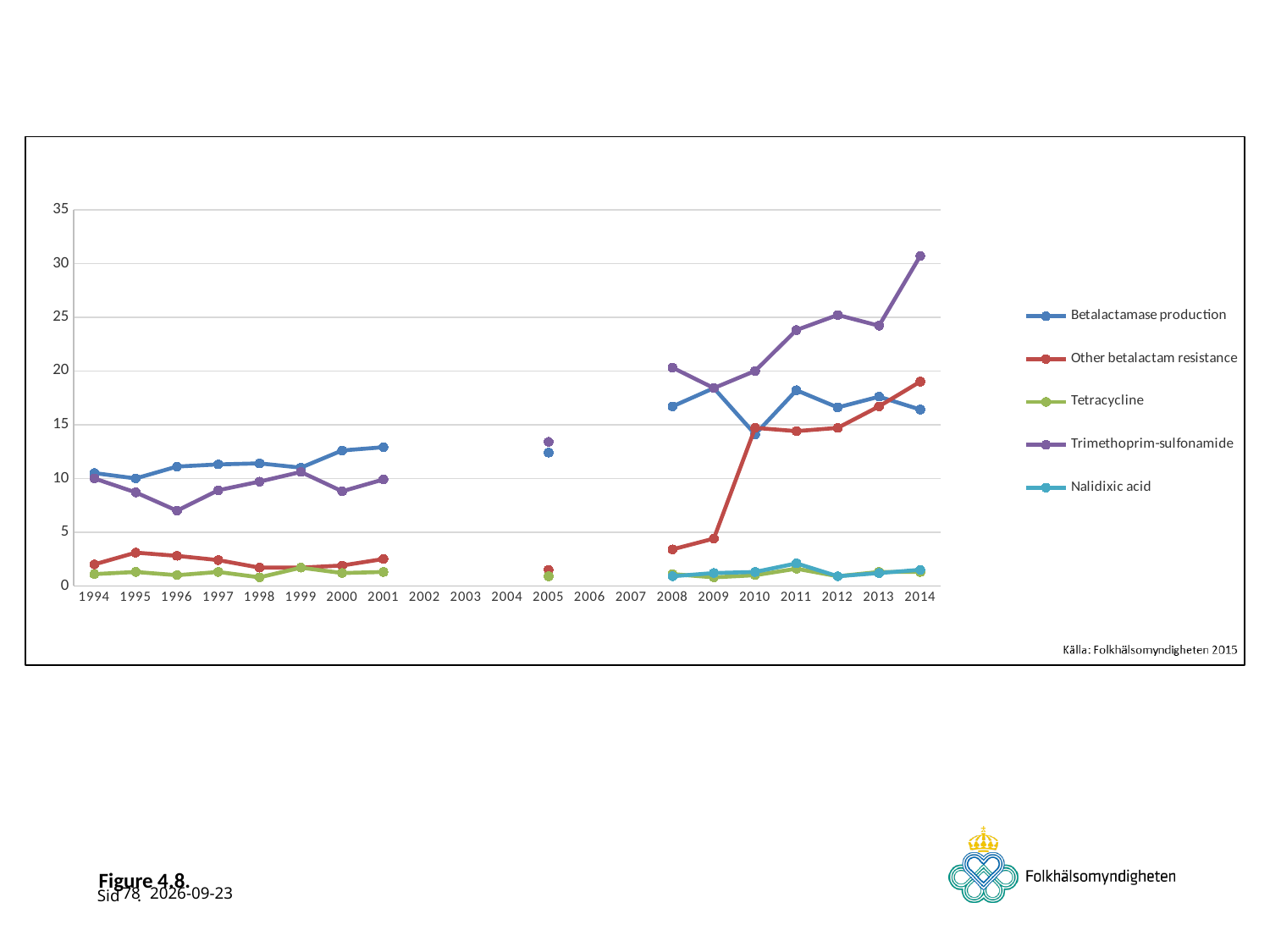
Is the value for Betalactamase production in 2014 greater or less than 20? less In 2009, which is larger: Other betalactam resistance or Betalactamase production? Betalactamase production How many year labels are shown along the x axis? 21 Is the value for Trimethoprim-sulfonamide in 2014 greater or less than 25? greater In 2010, which is larger: Betalactamase production or Trimethoprim-sulfonamide? Trimethoprim-sulfonamide Is the value for Trimethoprim-sulfonamide in 1996 greater or less than 10? less How many series does the legend list? 5 Which series has the highest value in 2014? Trimethoprim-sulfonamide Does the Trimethoprim-sulfonamide line rise or fall overall from 2008 to 2014? rise What source is cited at the bottom right of the chart? Källa: Folkhälsomyndigheten 2015 What kind of chart is shown on the slide? line chart